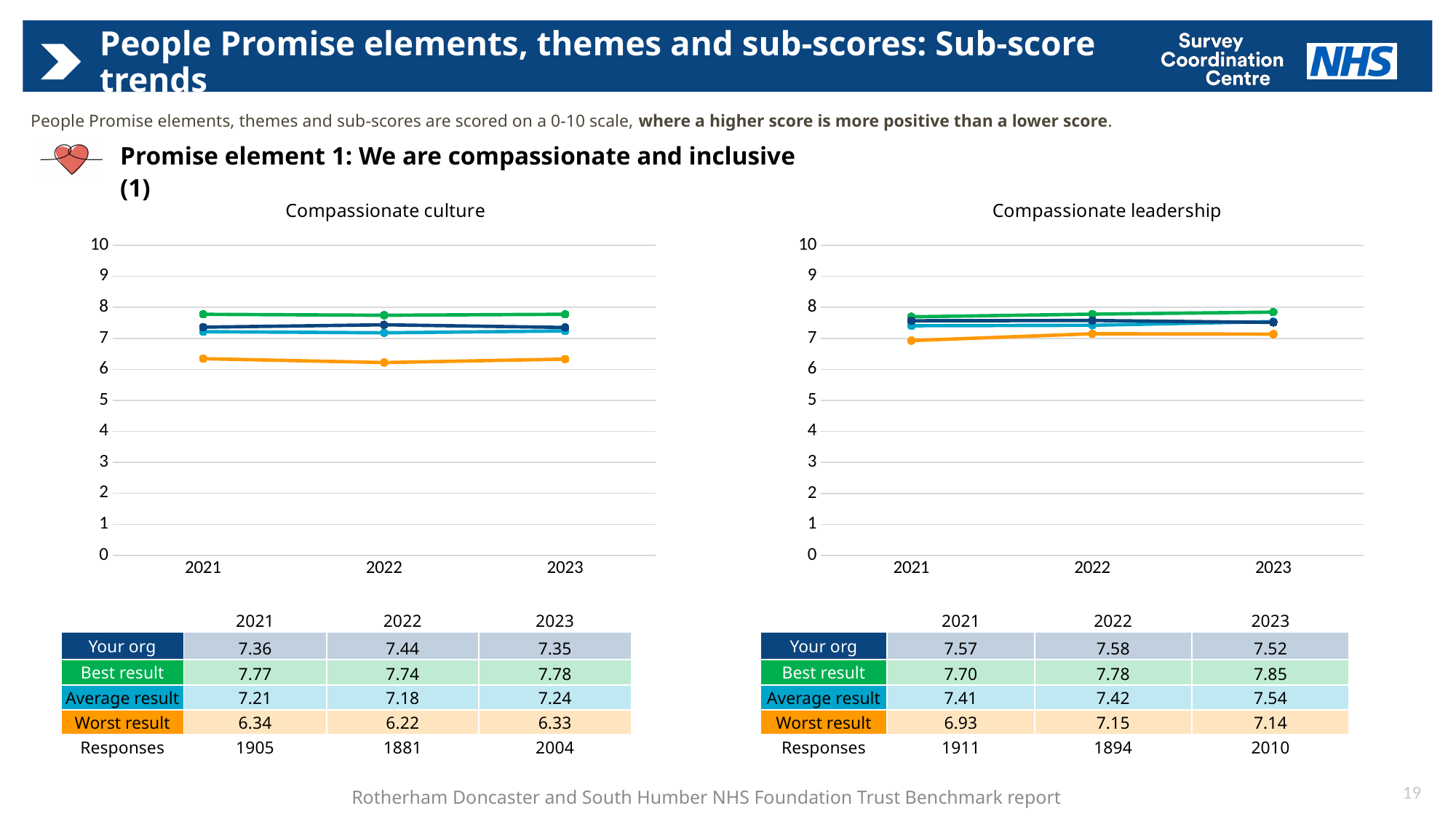
In the Compassionate culture chart, what is the Your org score for 2022? 7.44 In the Compassionate culture chart, is the Worst result for 2021 greater or less than 7? less In the Compassionate culture chart, what is the Average result score for 2023? 7.24 In the Compassionate culture chart, which year has the lowest Worst result score? 2022 In the Compassionate leadership chart, what is the Best result score for 2023? 7.85 In the Compassionate leadership chart, what is the difference between the Your org score and the Average result in 2023? -0.02 What type of chart is the Compassionate leadership chart? Line chart In the Compassionate culture chart, what is the difference between the Best result and the Worst result in 2022? 1.52 In the Compassionate leadership chart, what is the Worst result score for 2021? 6.93 In the Compassionate leadership chart, which year has the highest Best result score? 2023 How many years are plotted on the x axis of the Compassionate culture chart? 3 In the Compassionate leadership chart, is the Your org score higher in 2021 or in 2023? 2021